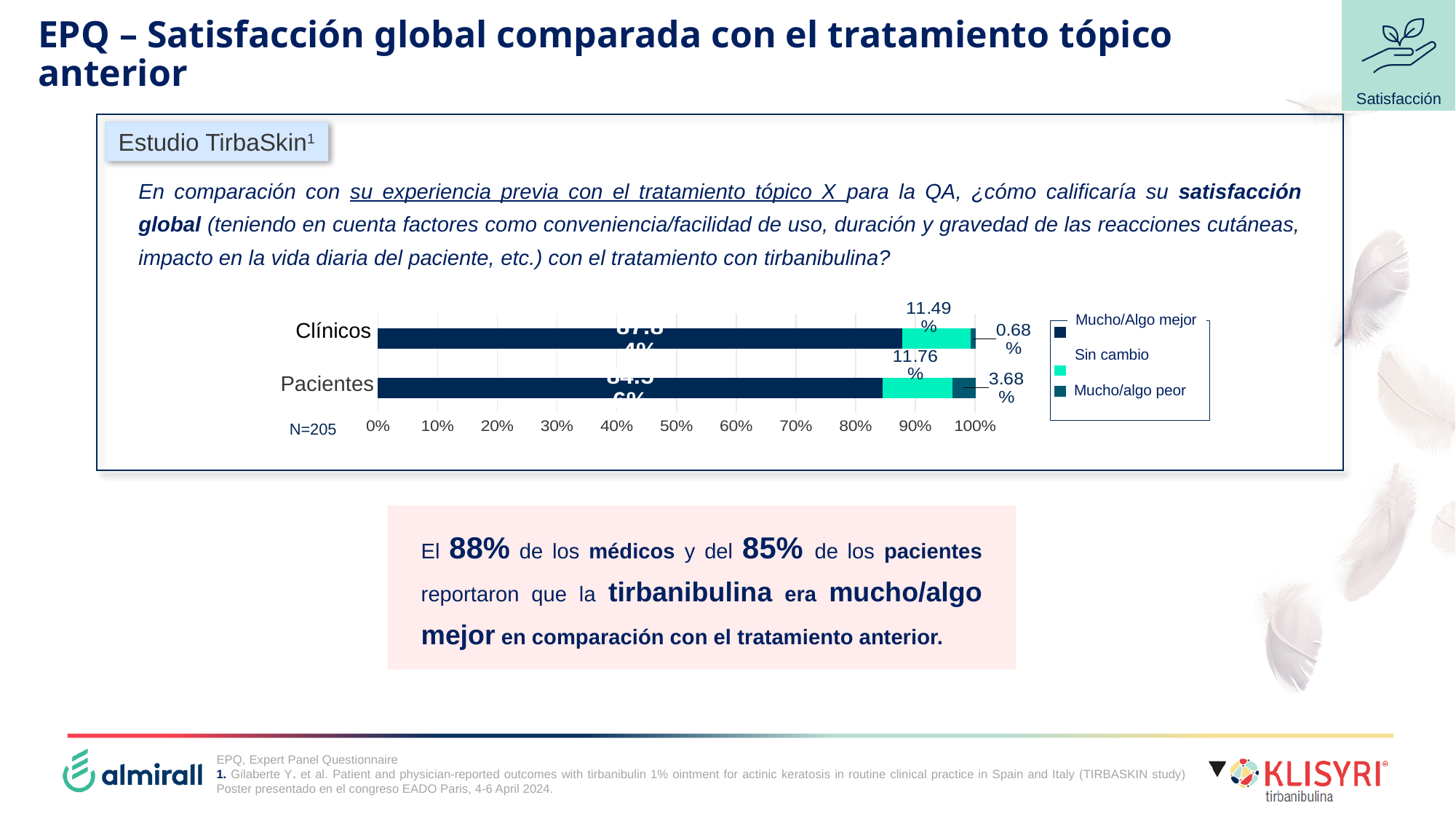
Which group has the larger 'Mucho/algo peor' value, Clínicos or Pacientes? Pacientes What kind of chart is shown on the slide? bar chart How many categories (groups) are plotted on the chart? 2 What is the 'Mucho/algo peor' value for Pacientes? 3.68% What sample size (N) is shown next to the chart? N=205 What is the difference between the 'Mucho/algo peor' values for Pacientes and Clínicos? 3.00% How many series does the chart legend list? 3 What is the 'Mucho/algo peor' value for Clínicos? 0.68% Is the 'Mucho/Algo mejor' value for Clínicos greater or less than 80%? greater What is the 'Sin cambio' value for Clínicos? 11.49% What is the 'Sin cambio' value for Pacientes? 11.76% What is the difference between the 'Sin cambio' values for Pacientes and Clínicos? 0.27%